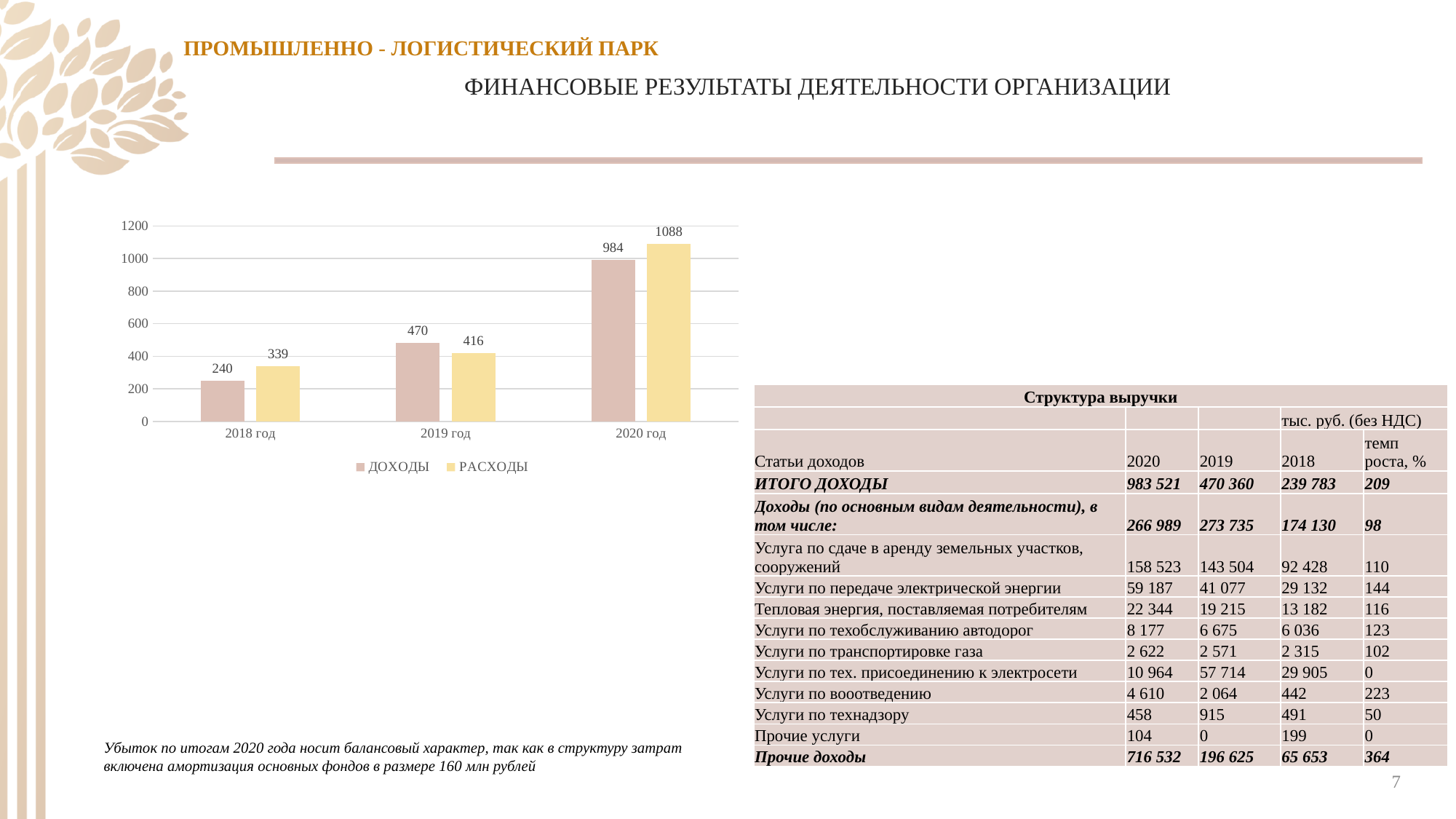
What is the value of РАСХОДЫ for 2020 год? 1088 What is the value of ДОХОДЫ for 2018 год? 240 What is the difference between ДОХОДЫ in 2019 год and ДОХОДЫ in 2018 год? 230 In 2019 год, which is larger: ДОХОДЫ or РАСХОДЫ? ДОХОДЫ How many years are shown on the x axis of the chart? 3 What kind of chart is shown on the slide? bar chart Do the values of ДОХОДЫ rise or fall from 2018 год to 2020 год? rise Which year has the highest value of ДОХОДЫ? 2020 год What is the value of РАСХОДЫ for 2019 год? 416 Which year has the lowest value of РАСХОДЫ? 2018 год What is the difference between РАСХОДЫ and ДОХОДЫ in 2020 год? 104 How many series does the chart legend list? 2